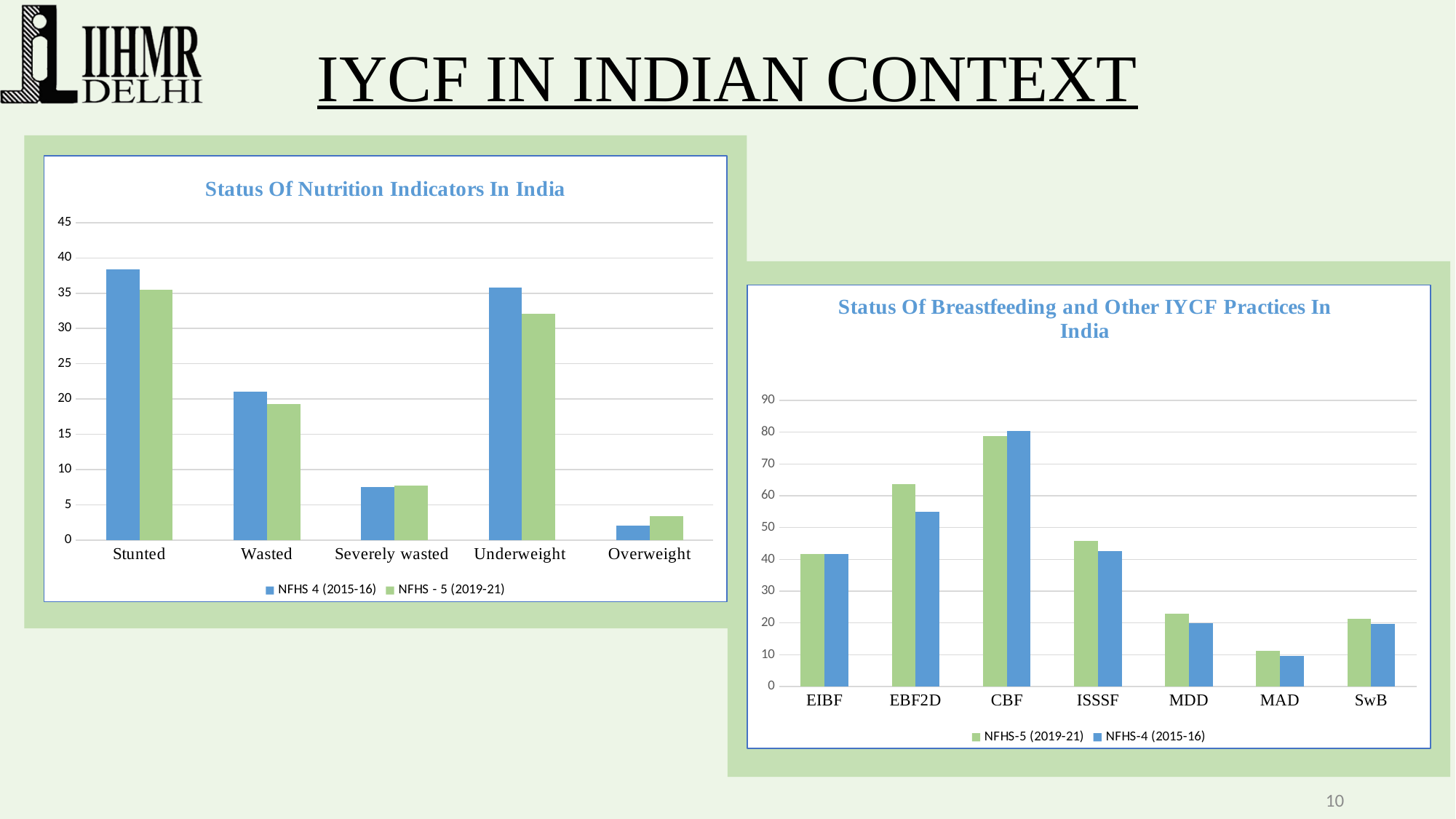
In the 'Status Of Nutrition Indicators In India' chart, how many categories are shown on the x axis? 5 In the 'Status Of Nutrition Indicators In India' chart, which category has the lowest NFHS - 5 (2019-21) value? Overweight In the 'Status Of Nutrition Indicators In India' chart, for Wasted, which series has the larger value: NFHS 4 (2015-16) or NFHS - 5 (2019-21)? NFHS 4 (2015-16) In the 'Status Of Breastfeeding and Other IYCF Practices In India' chart, is the NFHS-5 (2019-21) value for EBF2D greater or less than 60? greater In the 'Status Of Nutrition Indicators In India' chart, which category has the highest NFHS 4 (2015-16) value? Stunted In the 'Status Of Breastfeeding and Other IYCF Practices In India' chart, which category has the highest NFHS-5 (2019-21) value? CBF In the 'Status Of Breastfeeding and Other IYCF Practices In India' chart, which colour represents NFHS-5 (2019-21)? green In the 'Status Of Nutrition Indicators In India' chart, is the NFHS - 5 (2019-21) value for Underweight greater or less than 35? less In the 'Status Of Nutrition Indicators In India' chart, how many series does the legend list? 2 What kind of chart is the 'Status Of Nutrition Indicators In India' chart? bar chart In the 'Status Of Breastfeeding and Other IYCF Practices In India' chart, which category has the lowest NFHS-4 (2015-16) value? MAD In the 'Status Of Breastfeeding and Other IYCF Practices In India' chart, how many categories are shown on the x axis? 7